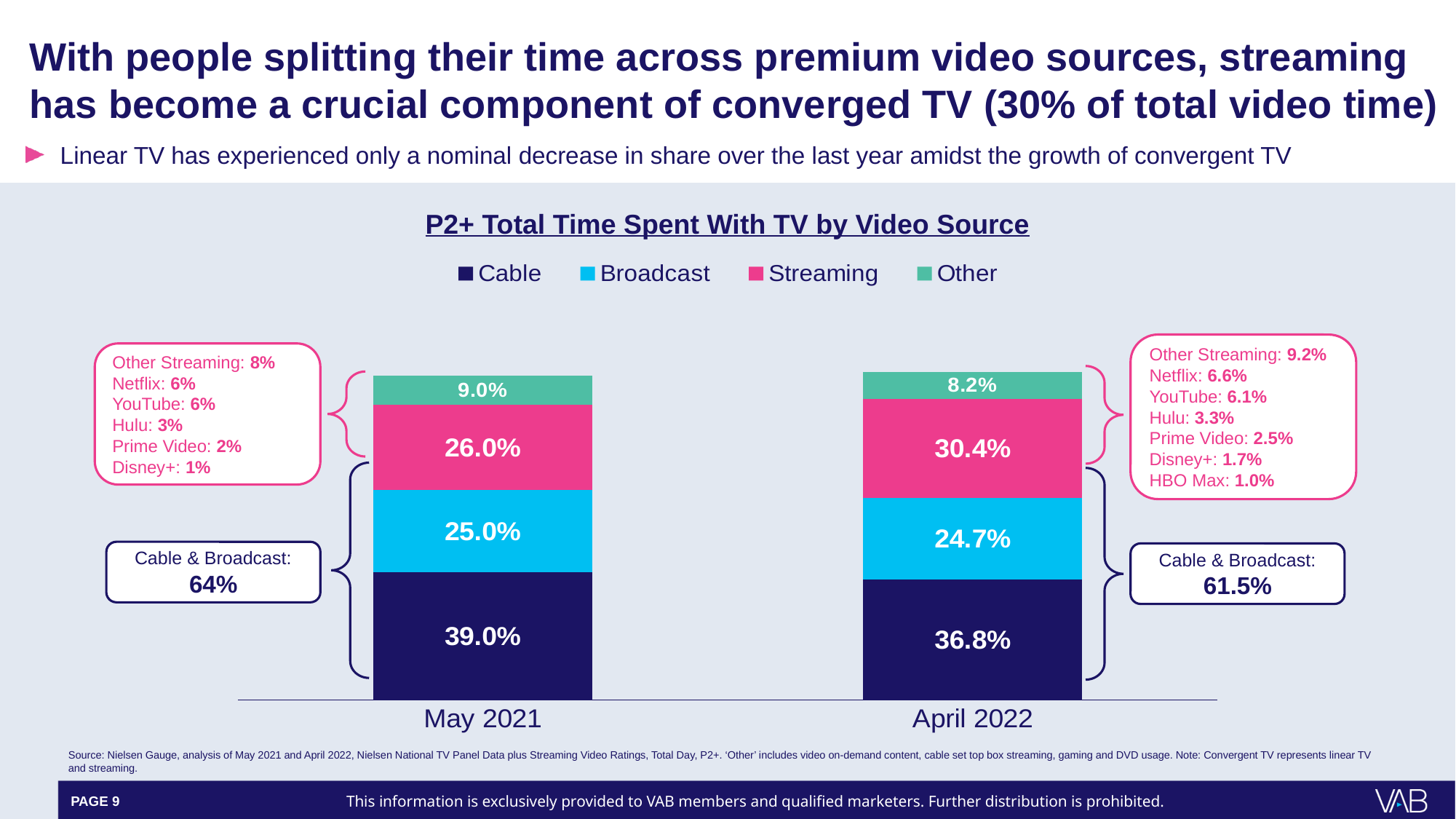
What is the Streaming share in April 2022? 30.4% What is the Cable share in May 2021? 39.0% What is the title of the chart? P2+ Total Time Spent With TV by Video Source How many time periods are shown on the x axis? 2 Which video source has the smallest share in May 2021? Other Is the Cable share larger in May 2021 or April 2022? May 2021 How many series does the legend list? 4 Which video source has the largest share in April 2022? Cable What is the Broadcast share in April 2022? 24.7% By how many percentage points did the Streaming share change from May 2021 to April 2022? 4.4 percentage points What is the Other share in May 2021? 9.0% What kind of chart is shown? Stacked bar chart